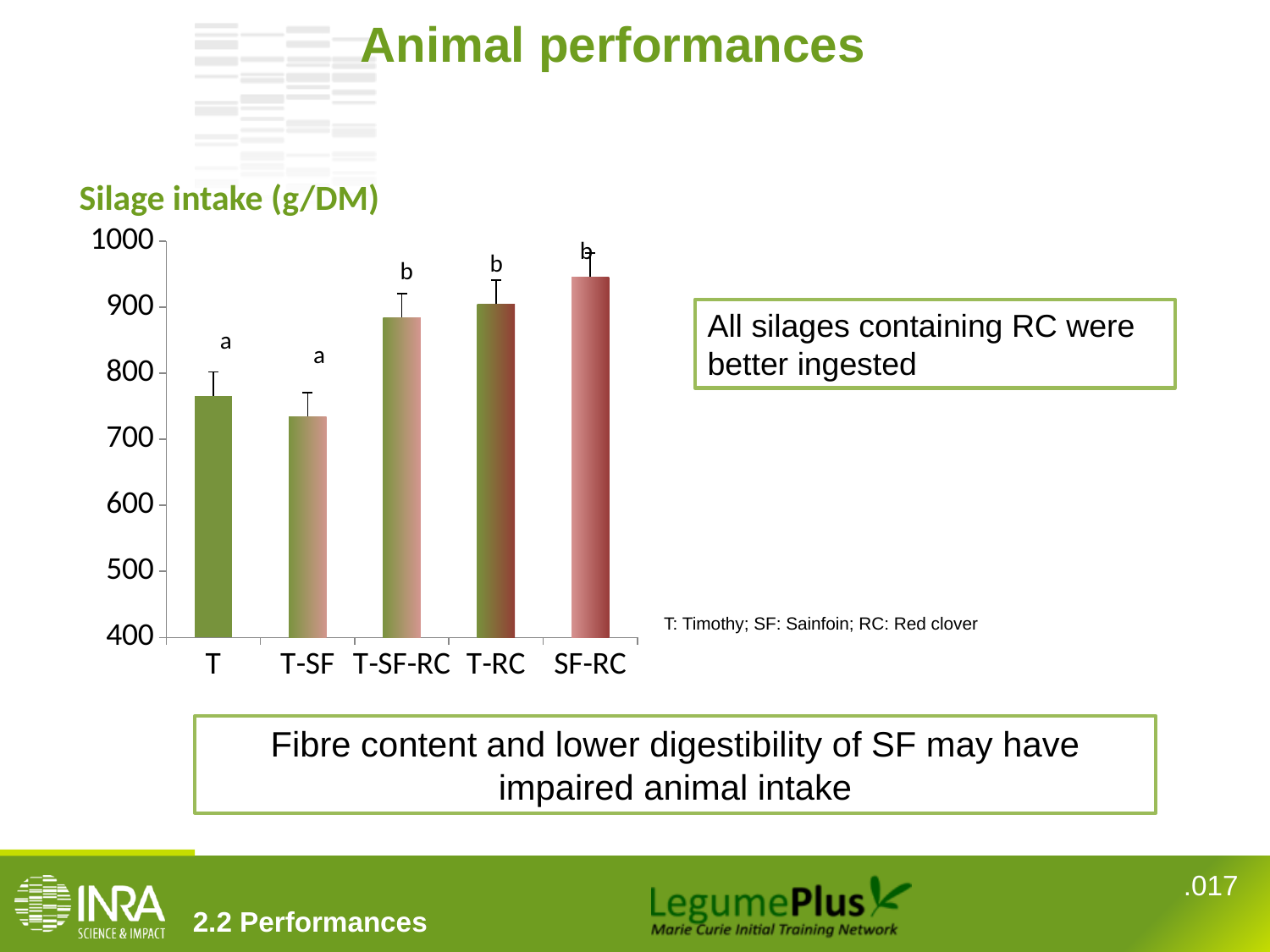
Is the silage intake for T-SF-RC greater or less than 800? greater Which has the larger silage intake, T-SF or T-SF-RC? T-SF-RC Which has the larger silage intake, T or SF-RC? SF-RC Is the silage intake for SF-RC greater or less than 900? greater Is the silage intake for T greater or less than 800? less How many silage categories are plotted on the x axis? 5 Which silage has the lowest intake? T-SF What kind of chart is shown on the slide? bar chart What letter is printed above the T-RC bar? b Which silage has the highest intake? SF-RC What is the title of the chart? Silage intake (g/DM)